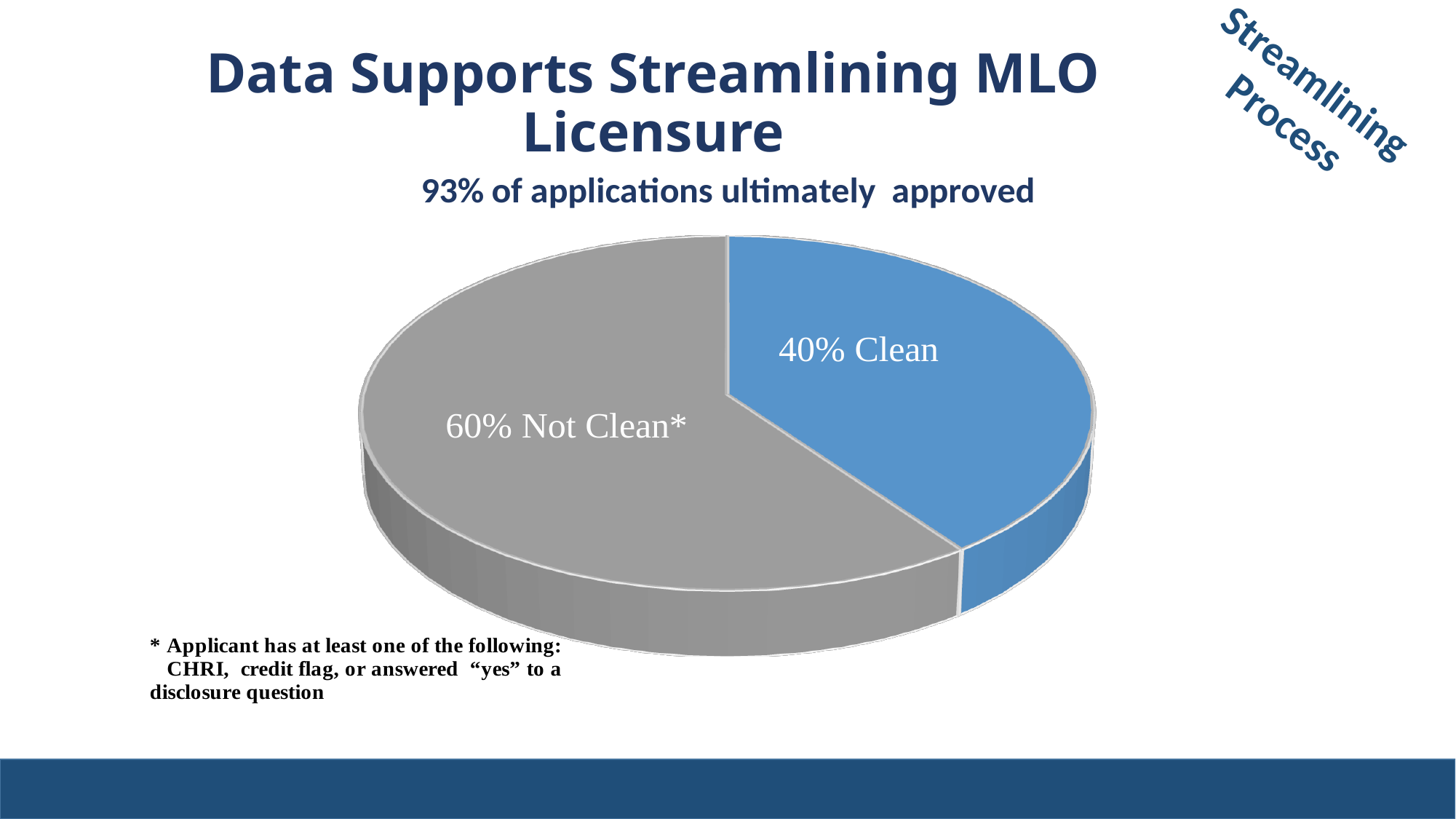
What kind of chart is shown on the slide? Pie chart What is the subtitle shown above the pie chart? 93% of applications ultimately approved What is the difference in percentage points between the Not Clean* slice and the Clean slice? 20% Which slice of the pie is the largest? Not Clean* How many slices does the pie chart have? 2 Which slice of the pie is the smallest? Clean What colour is the Clean slice of the pie? Blue Is the share for Clean greater or less than 50%? less What is the total of the two pie slice percentages? 100% Which is larger, the Clean slice or the Not Clean* slice? Not Clean* What share of the pie is labelled Clean? 40% What share of the pie is labelled Not Clean*? 60%